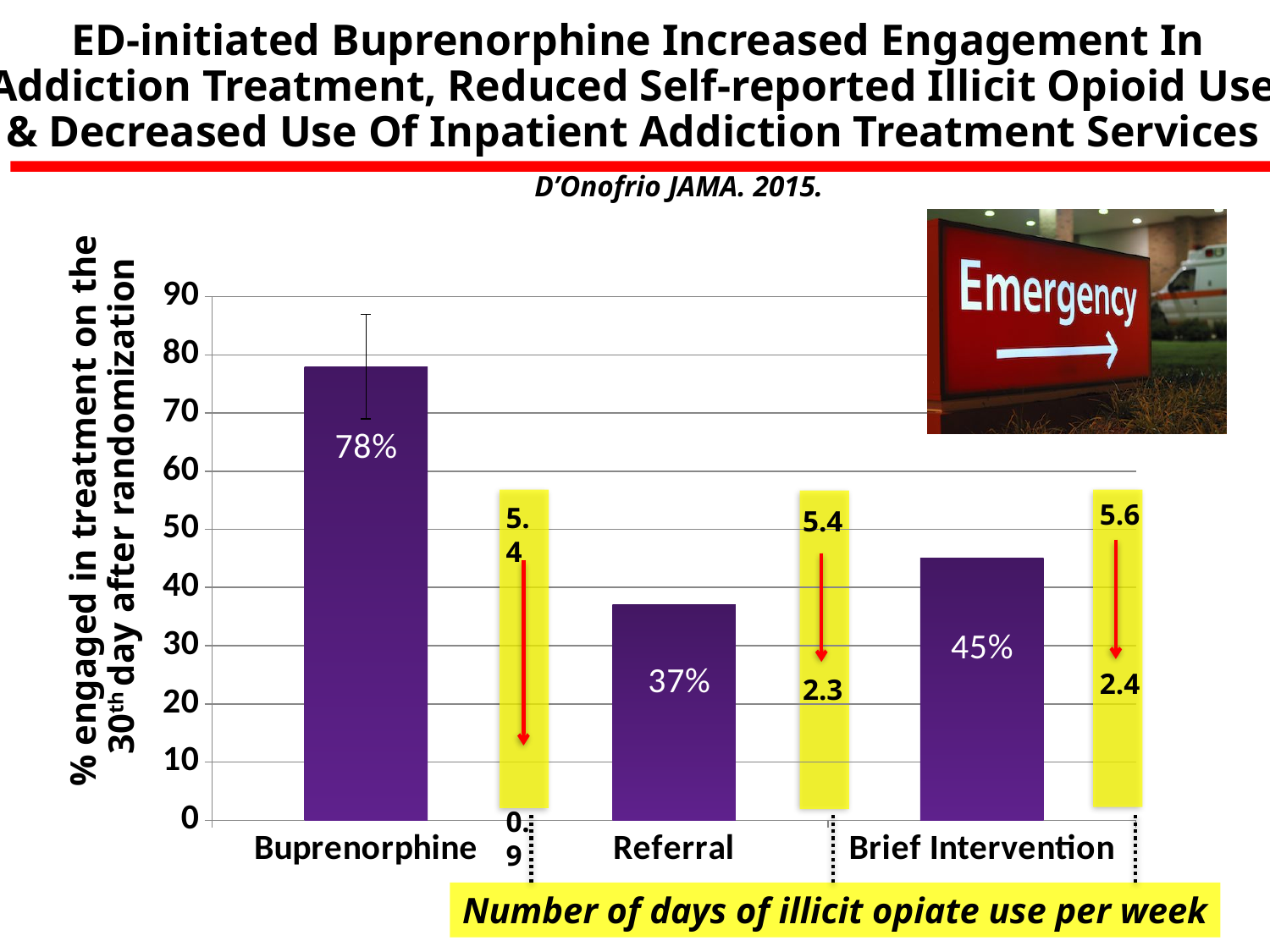
How many treatment groups are shown on the x axis of the chart? 3 What percentage of patients in the Referral group were engaged in treatment on the 30th day after randomization? 37% According to the yellow annotation, how many days of illicit opiate use per week did the Brief Intervention group report after treatment? 2.4 Which group had a higher percentage engaged in treatment: Brief Intervention or Referral? Brief Intervention Which group had the lowest percentage engaged in treatment on the 30th day? Referral Which group had the highest percentage engaged in treatment on the 30th day? Buprenorphine What percentage of patients in the Buprenorphine group were engaged in treatment on the 30th day after randomization? 78% What percentage of patients in the Brief Intervention group were engaged in treatment on the 30th day after randomization? 45% What is the label of the y axis of the chart? % engaged in treatment on the 30th day after randomization What is the difference in percentage engaged in treatment between the Buprenorphine and Referral groups? 41% What kind of chart is used to show the percentage engaged in treatment? Bar chart According to the yellow annotation, how many days of illicit opiate use per week did the Referral group report after treatment? 2.3